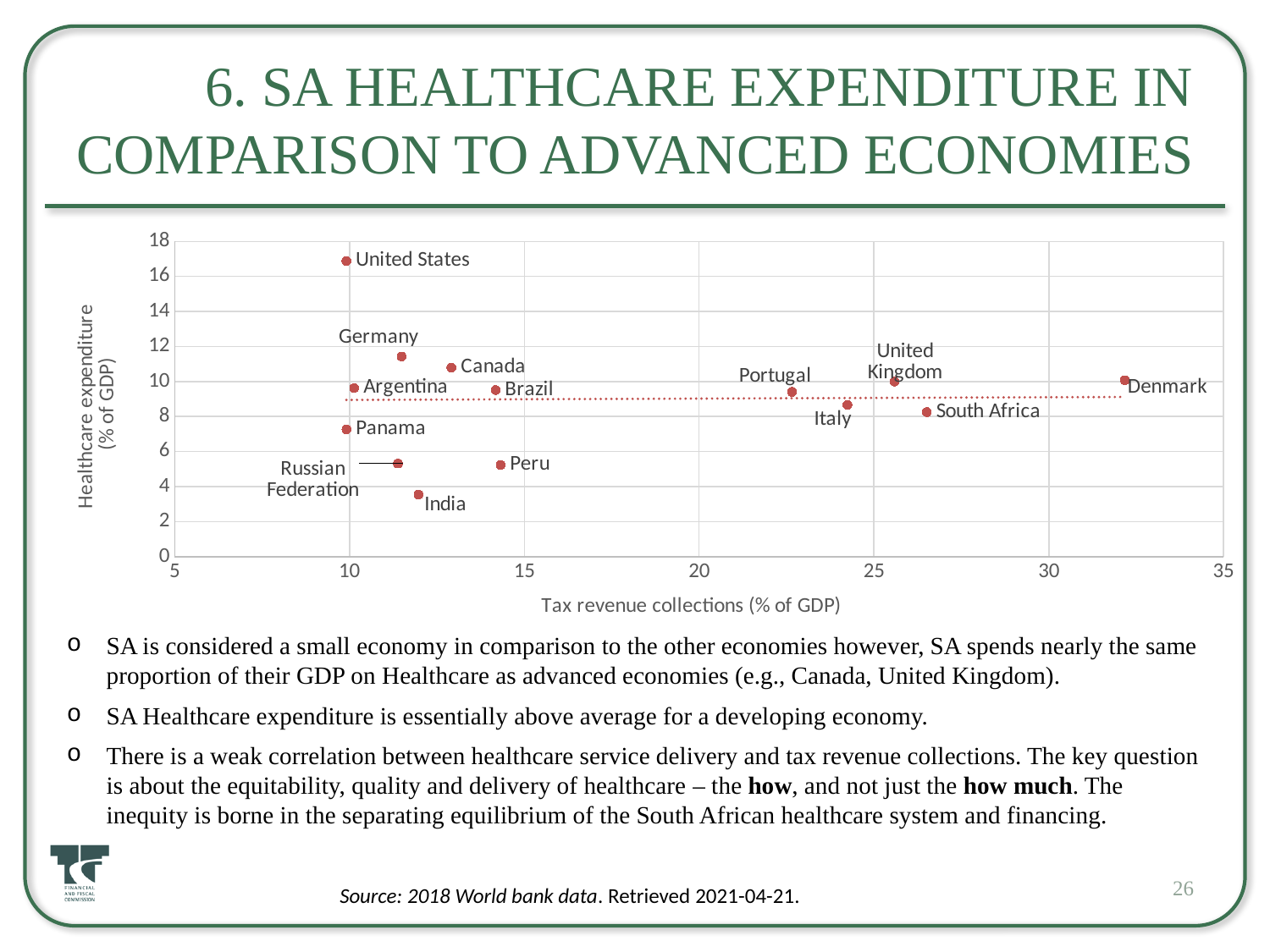
Is the tax revenue collection for Denmark greater or less than 30? greater Which has the higher healthcare expenditure, Argentina or Panama? Argentina Which country has the highest healthcare expenditure (% of GDP) on the chart? United States What kind of chart is shown on the slide? Scatter chart Which has the higher healthcare expenditure, Germany or Canada? Germany Which country has the lowest healthcare expenditure (% of GDP) on the chart? India Is the tax revenue collection for South Africa greater or less than 25? greater Is the healthcare expenditure for the United States greater or less than 16? greater What is the label of the horizontal axis of the chart? Tax revenue collections (% of GDP) How many countries are plotted on the chart? 14 Which country has the highest tax revenue collections (% of GDP) on the chart? Denmark